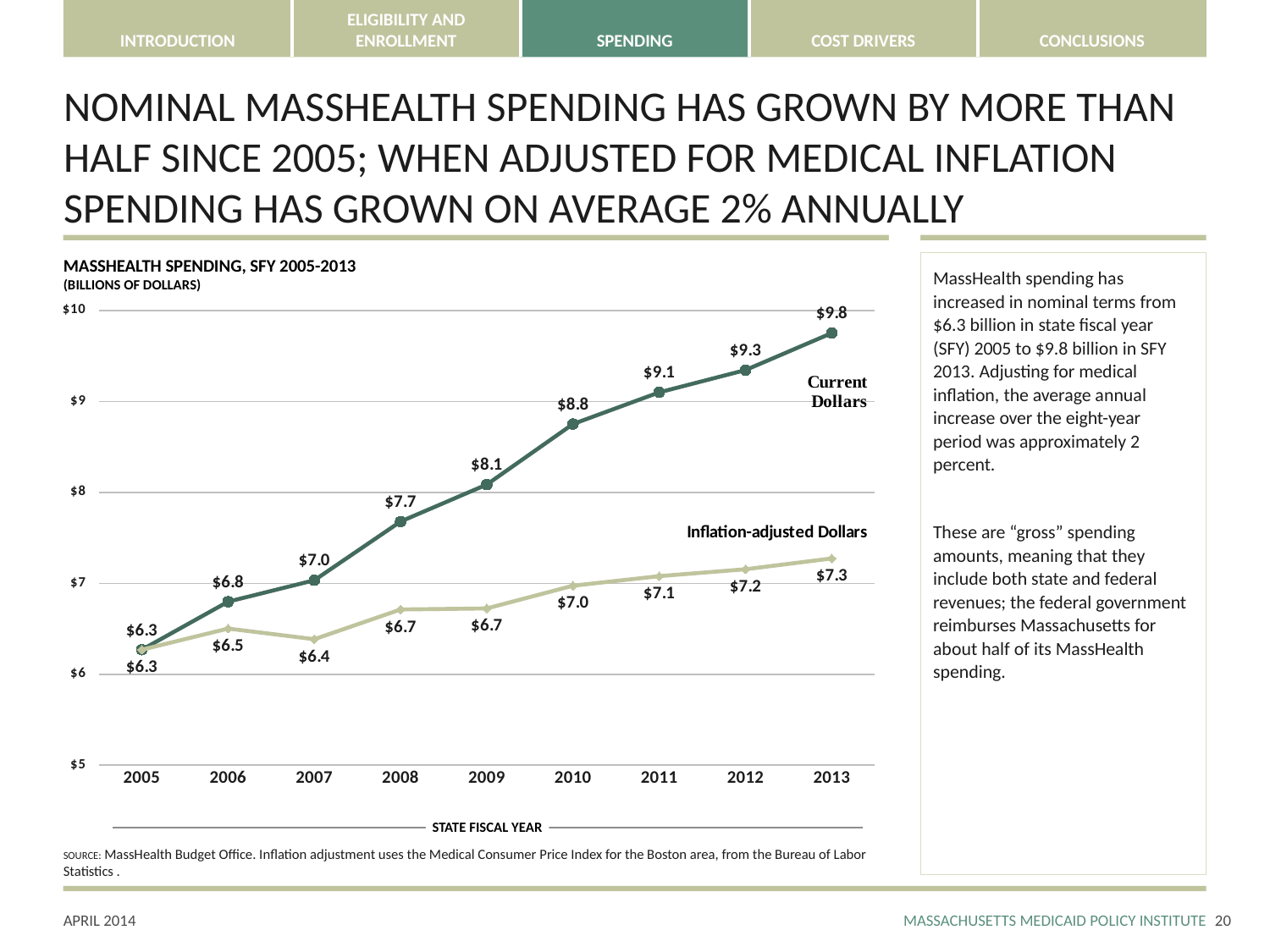
Does current-dollar MassHealth spending rise or fall from 2005 to 2013? Rise What is the difference between current dollars and inflation-adjusted dollars in 2013? $2.5 What was MassHealth spending in current dollars in 2013? $9.8 How many data series are shown in the chart? 2 What type of chart is shown on the slide? Line chart In which year was inflation-adjusted MassHealth spending lowest? 2005 In which year was current-dollar MassHealth spending highest? 2013 Which is larger in 2010: current dollars or inflation-adjusted dollars? Current Dollars What was MassHealth spending in current dollars in 2009? $8.1 What is the title of the chart? MassHealth Spending, SFY 2005-2013 What was MassHealth spending in inflation-adjusted dollars in 2007? $6.4 How many state fiscal years are plotted on the x axis? 9